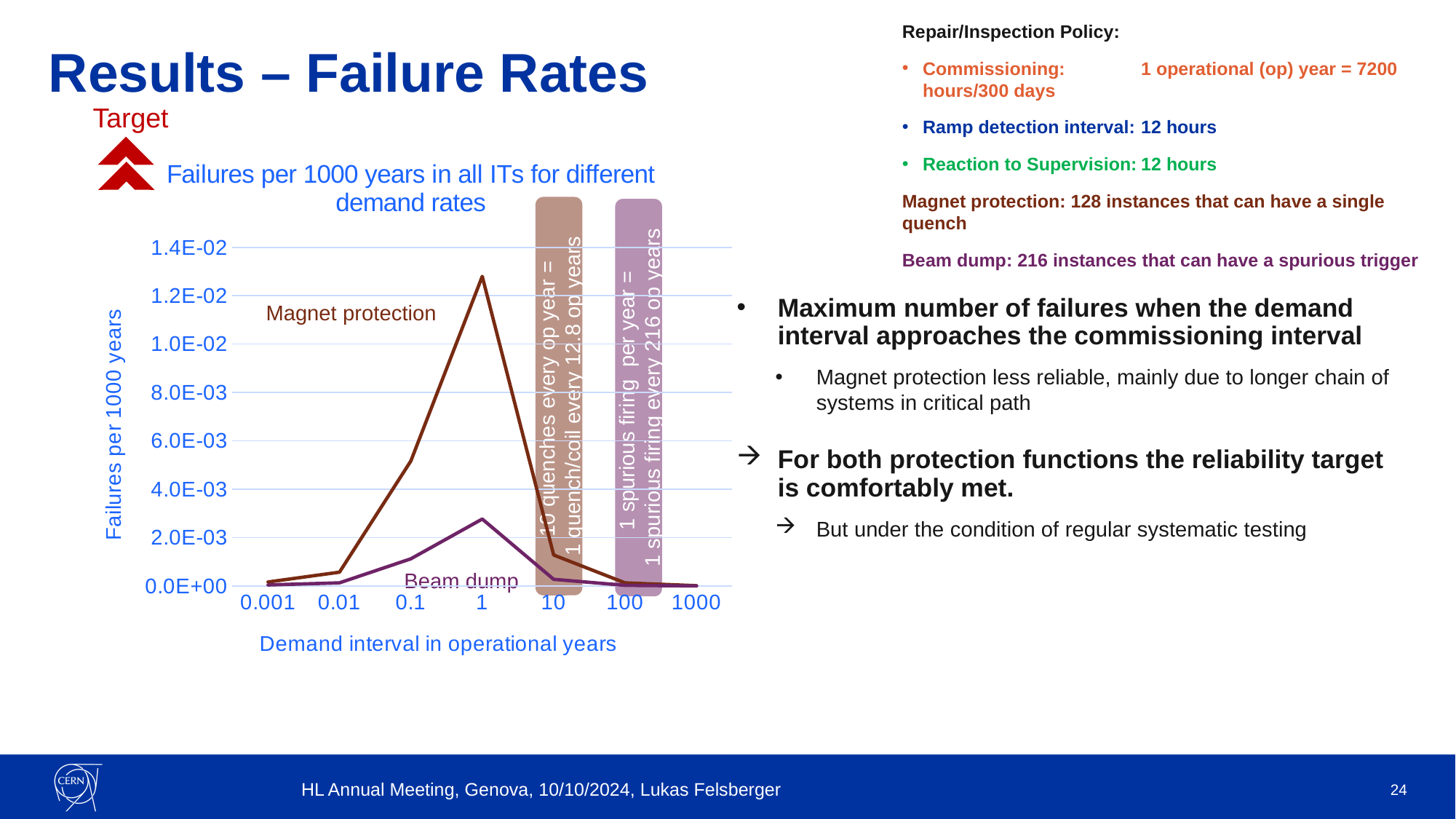
At which demand interval does the Beam dump series reach its highest value? 1 What is the title of the chart? Failures per 1000 years in all ITs for different demand rates At which demand interval does the Magnet protection series reach its highest value? 1 Is the Magnet protection value at a demand interval of 0.1 greater or less than 4.0E-03? greater Do the Magnet protection values rise or fall as the demand interval increases from 1 to 1000 operational years? fall At a demand interval of 1 operational year, which series has the larger value, Magnet protection or Beam dump? Magnet protection What is the label of the x axis of the chart? Demand interval in operational years How many series are plotted in the chart? 2 Is the Beam dump value at a demand interval of 1 greater or less than 4.0E-03? less What kind of chart is shown on the slide? Line chart How many demand interval values are marked on the x axis? 7 Is the Magnet protection value at a demand interval of 1 greater or less than 1.2E-02? greater